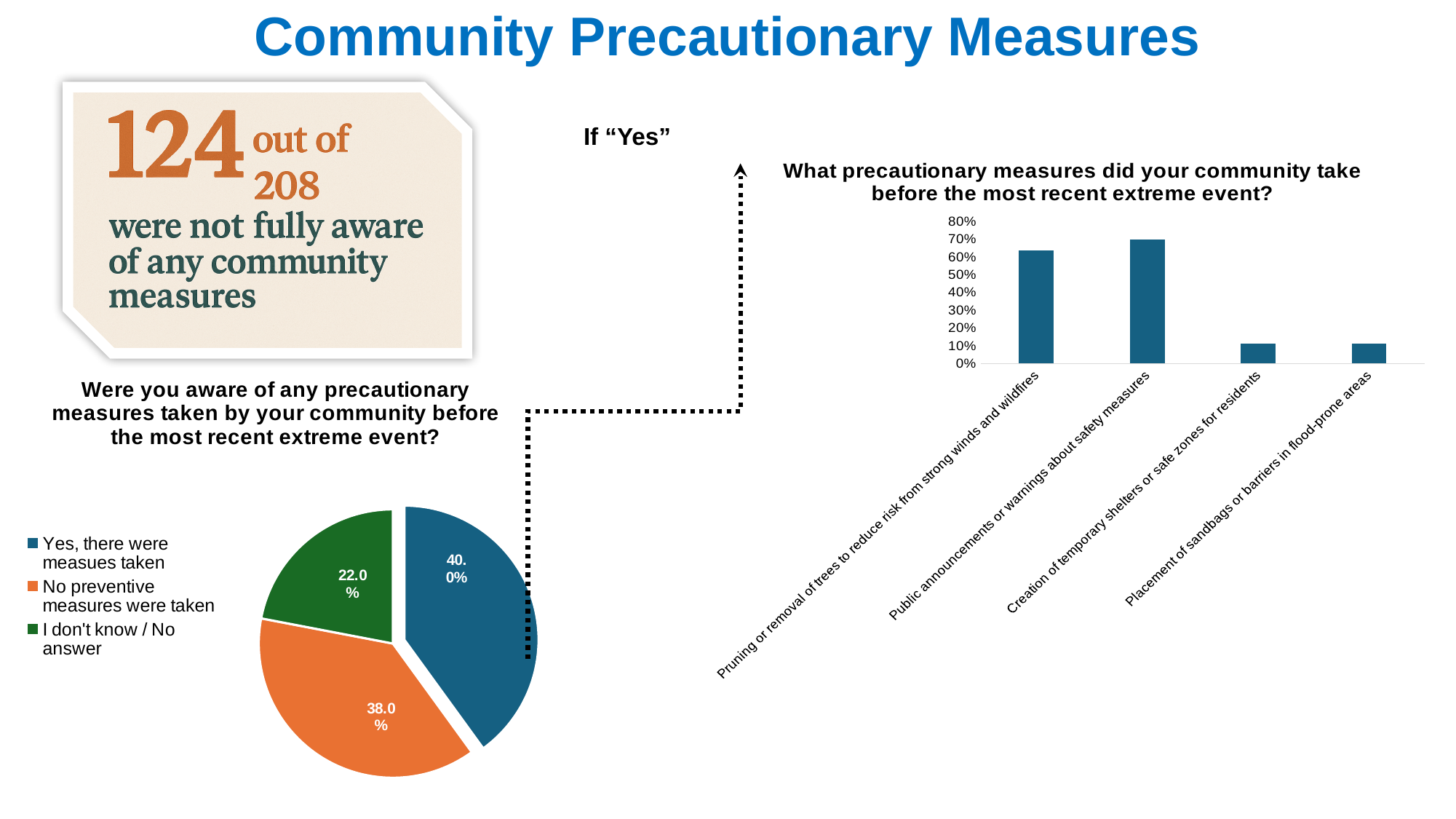
In the pie chart on the left, which response has the smallest share? I don't know / No answer In the pie chart on the left, which response has the largest share? Yes, there were measues taken In the bar chart on the right, is the value for 'Pruning or removal of trees to reduce risk from strong winds and wildfires' greater or less than 50%? greater In the bar chart on the right, which precautionary measure has the highest value? Public announcements or warnings about safety measures In the bar chart on the right, is the value for 'Creation of temporary shelters or safe zones for residents' greater or less than 20%? less In the pie chart on the left, what percentage corresponds to 'I don't know / No answer'? 22.0% How many slices does the pie chart on the left have? 3 What type of chart is the chart titled 'What precautionary measures did your community take before the most recent extreme event?'? Bar chart In the pie chart on the left, what percentage corresponds to 'No preventive measures were taken'? 38.0% In the pie chart on the left, what is the difference in percentage points between the 'Yes, there were measues taken' slice and the 'I don't know / No answer' slice? 18.0 percentage points In the pie chart 'Were you aware of any precautionary measures taken by your community before the most recent extreme event?', what share of respondents said 'Yes, there were measues taken'? 40.0% How many categories are shown in the bar chart on the right? 4